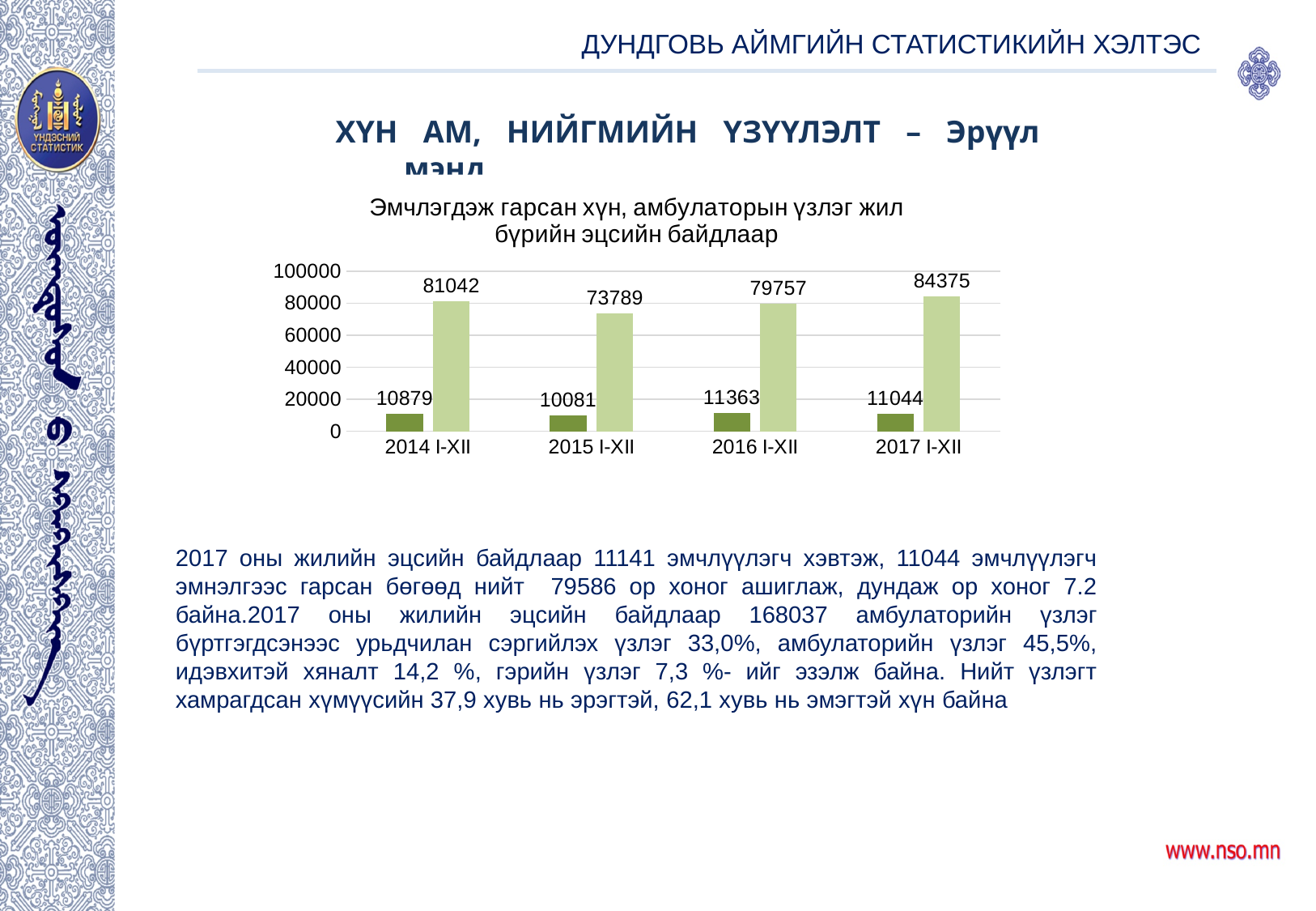
What is the value of the dark green bar for 2016 I-XII? 11363 What is the title of the chart? Эмчлэгдэж гарсан хүн, амбулаторын үзлэг жил бүрийн эцсийн байдлаар What is the value of the dark green bar for 2015 I-XII? 10081 In which year is the light green bar the highest? 2017 I-XII In which year is the light green bar the lowest? 2015 I-XII How many categories (years) are shown on the x axis of the chart? 4 What type of chart is shown on the slide? bar chart What is the value of the light green bar for 2017 I-XII? 84375 What is the difference between the light green bar values for 2017 I-XII and 2016 I-XII? 4618 What is the value of the light green bar for 2014 I-XII? 81042 Which is larger: the dark green bar for 2016 I-XII or the dark green bar for 2017 I-XII? 2016 I-XII In which year is the dark green bar the lowest? 2015 I-XII